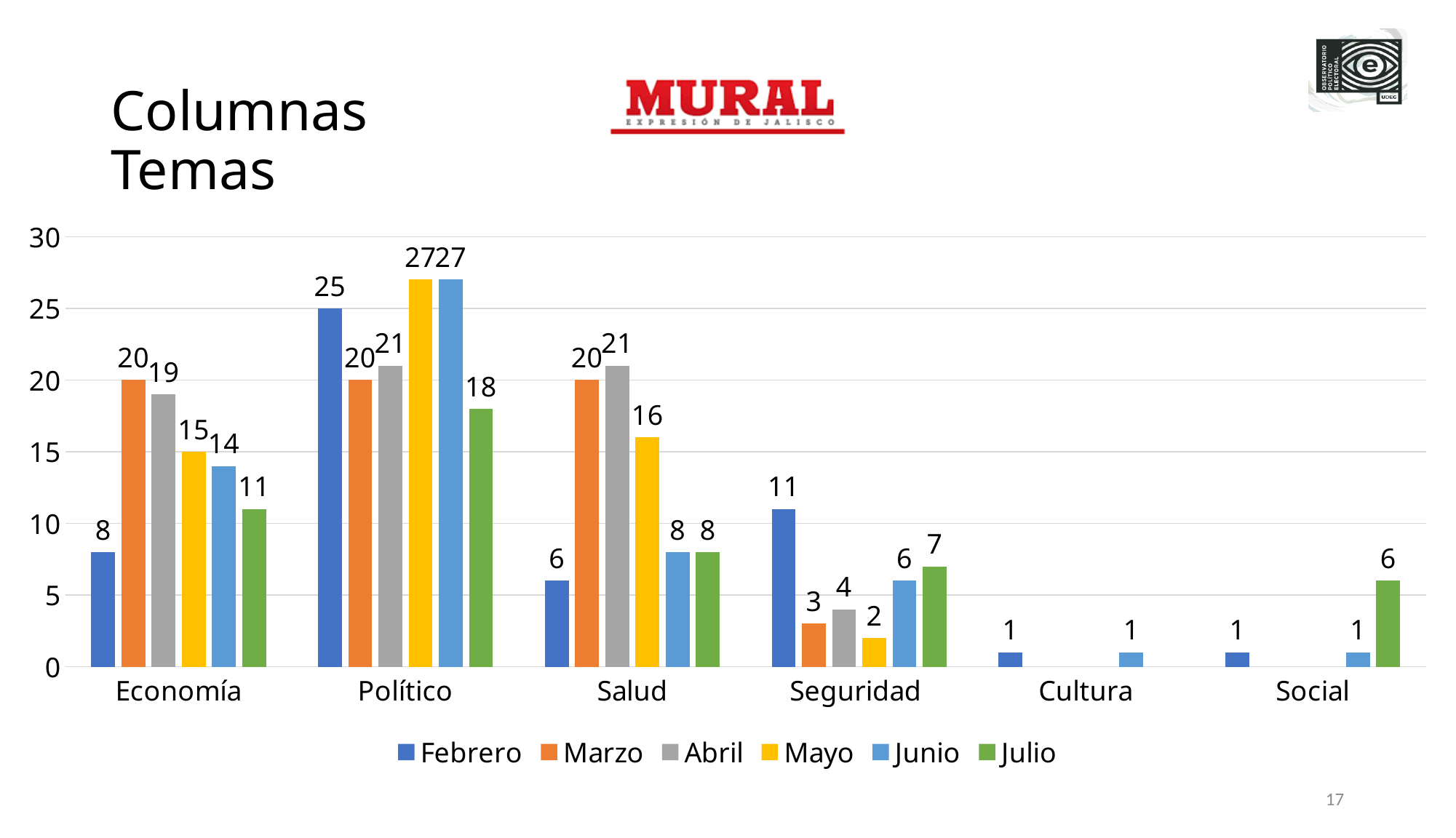
What is the value for Julio in the Político category? 18 Which month has the highest value in the Seguridad category? Febrero How many series does the legend list? 6 Which month has the lowest value in the Economía category? Febrero What is the value for Julio in the Social category? 6 What is the value for Marzo in the Economía category? 20 What is the title of the slide containing the chart? Columnas Temas What kind of chart is shown on the slide? Bar chart What is the value for Mayo in the Salud category? 16 What is the difference between the Abril and Febrero values in the Salud category? 15 How many categories are shown on the x axis? 6 Which is larger in the Político category, the Febrero value or the Marzo value? Febrero